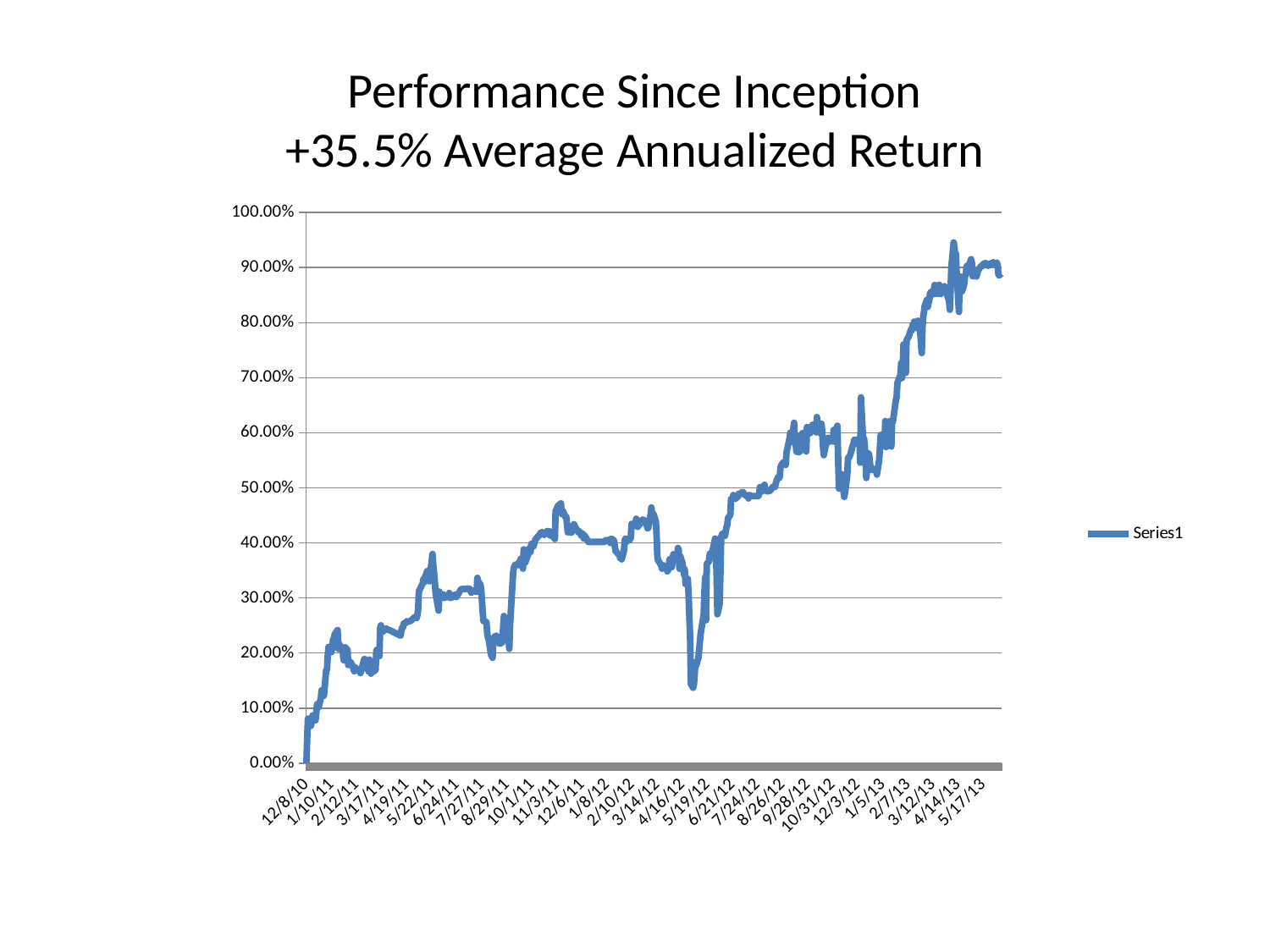
Is the value for 9/28/12 greater or less than 50.00%? greater Is the value for 11/3/11 greater or less than 50.00%? less Is the value for 5/17/13 greater or less than 80.00%? greater How many series does the legend list? 1 What kind of chart is shown on the slide? line chart Which is larger, the value at 7/24/12 or the value at 12/8/10? 7/24/12 Overall, do the values rise or fall from 12/8/10 to 5/17/13? rise What is the value of Series1 at the first date, 12/8/10? 0.00% What is the name of the series shown in the legend? Series1 Which date has the lowest value on the chart? 12/8/10 What is the title of the chart? Performance Since Inception +35.5% Average Annualized Return